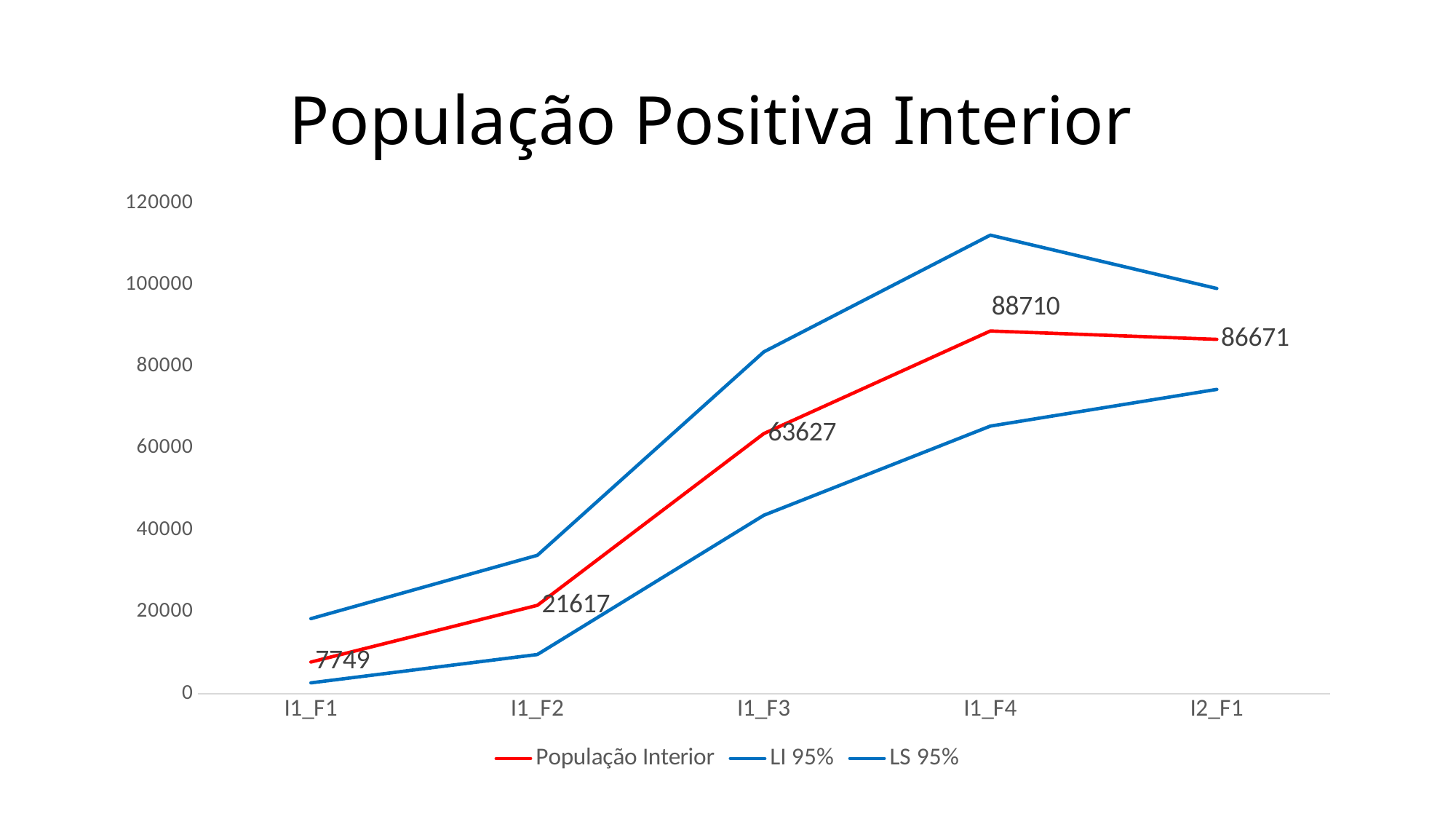
Which is larger for População Interior: the value at I1_F2 or at I1_F3? I1_F3 At which category does População Interior reach its highest value? I1_F4 How many categories are shown on the x axis? 5 What is the value of População Interior at I2_F1? 86671 At which category is População Interior lowest? I1_F1 Is the LI 95% value at I1_F2 greater or less than 20000? less Is the LS 95% value at I1_F4 greater or less than 100000? greater What is the difference between the População Interior values at I1_F4 and I1_F3? 25083 What is the value of População Interior at I1_F1? 7749 What kind of chart is shown on the slide? Line chart How many series does the legend list? 3 What is the value of População Interior at I1_F3? 63627